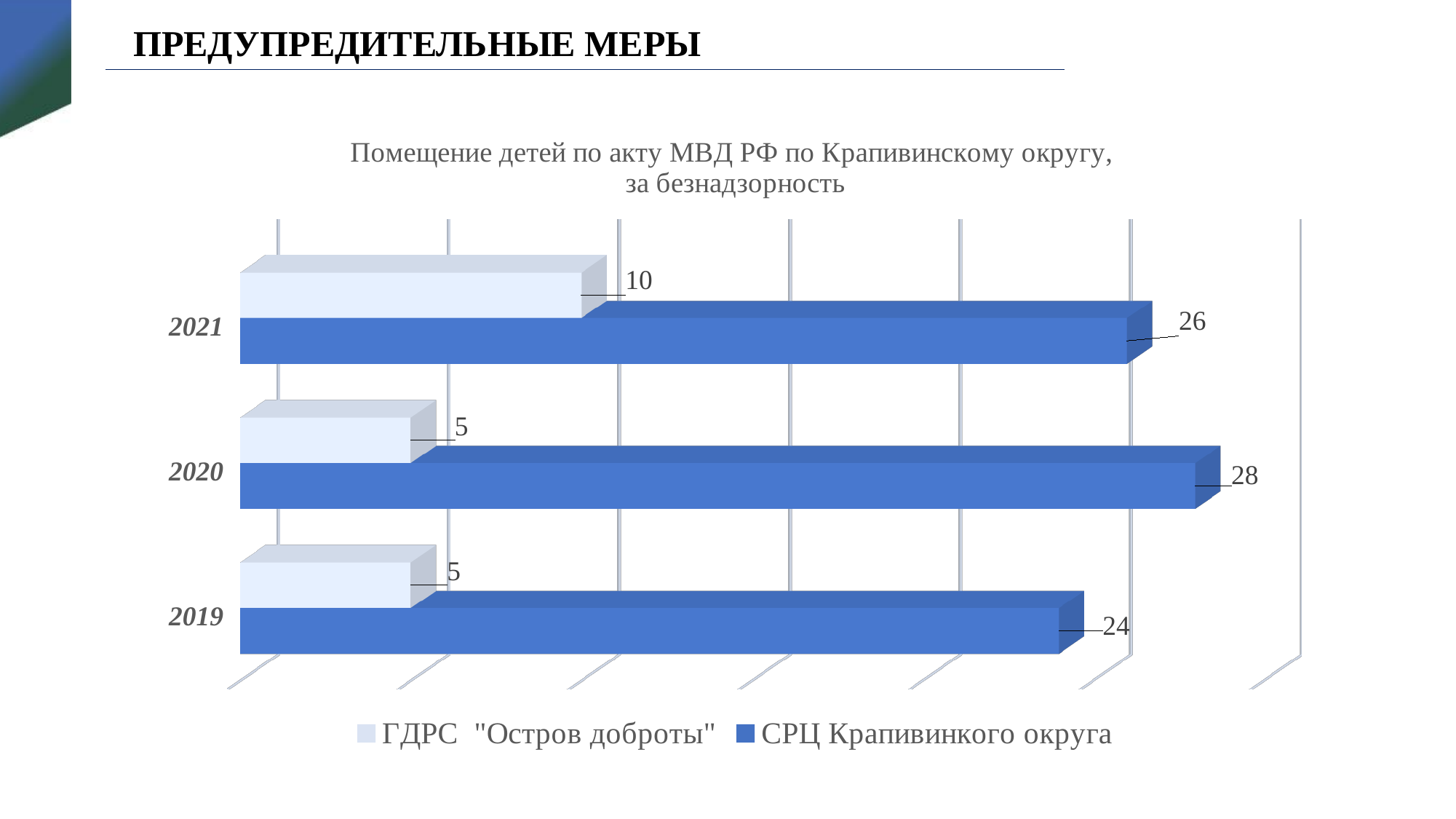
Which is larger in 2020: the value for СРЦ Крапивинкого округа or for ГДРС "Остров доброты"? СРЦ Крапивинкого округа What is the difference between the СРЦ Крапивинкого округа value and the ГДРС "Остров доброты" value in 2021? 16 What is the value for ГДРС "Остров доброты" in 2020? 5 How many years are shown on the chart? 3 In which year is the value for ГДРС "Остров доброты" highest? 2021 What is the value for СРЦ Крапивинкого округа in 2021? 26 In which year is the value for СРЦ Крапивинкого округа lowest? 2019 How many series does the legend list? 2 What is the value for СРЦ Крапивинкого округа in 2019? 24 What is the value for ГДРС "Остров доброты" in 2021? 10 What kind of chart is shown on the slide? Bar chart In which year is the value for СРЦ Крапивинкого округа highest? 2020